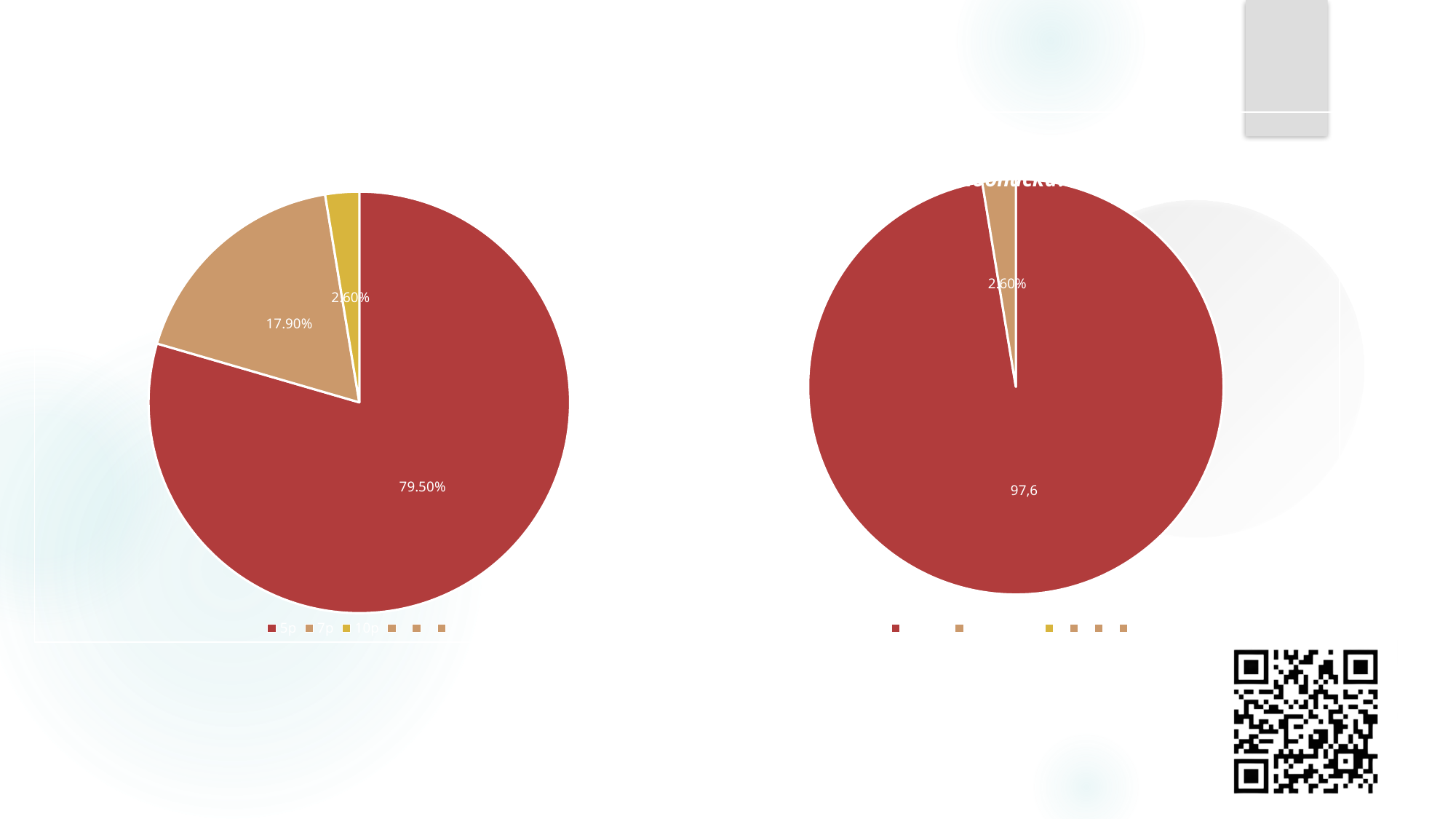
In the pie chart on the left, which is larger: the slice labelled 17.90% or the slice labelled 2.60%? 17.90% What type of chart is the chart on the left of the slide? pie chart In the pie chart on the left, what is the value of the smallest slice? 2.60% What type of chart is the chart on the right of the slide? pie chart How many slices does the pie chart on the right have? 2 In the pie chart on the left, what is the value of the largest slice? 79.50% Which chart has the larger dominant slice: the pie chart on the left (79.50%) or the pie chart on the right (97,6)? the pie chart on the right In the pie chart on the left, what is the difference between the largest slice (79.50%) and the second-largest slice (17.90%)? 61.60 percentage points In the pie chart on the right, what is the label of the largest slice? 97,6 In the pie chart on the right, what is the label of the smallest slice? 2.60% What colour is the largest slice in the pie chart on the left? red How many slices does the pie chart on the left have? 3